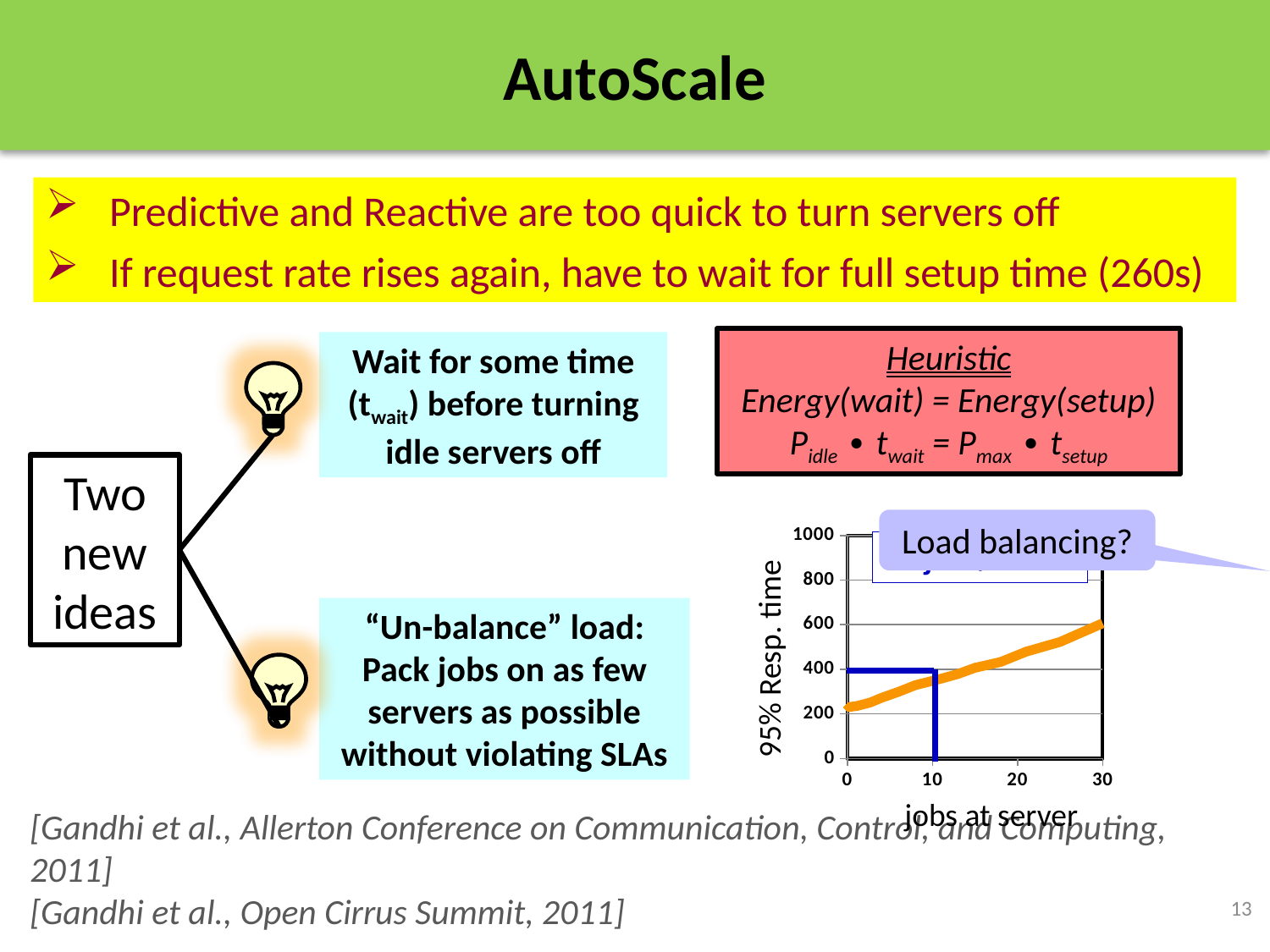
In the chart at the bottom right, is the 95% response time at 30 jobs at server greater or less than 400? greater In the chart at the bottom right, does the 95% response time rise or fall as the number of jobs at the server increases? rise In the chart at the bottom right, is the 95% response time at 30 jobs at server greater or less than 800? less In the chart at the bottom right, is the 95% response time higher at 30 jobs at server or at 0 jobs at server? 30 jobs at server In the chart at the bottom right, what is the label of the x axis? jobs at server In the chart at the bottom right, what is the highest value shown on the y axis? 1000 In the chart at the bottom right, what is the label of the y axis? 95% Resp. time What kind of chart is shown at the bottom right of the slide? line chart In the chart at the bottom right, what 95% response time do the blue guide lines mark at 10 jobs at server? 400 In the chart at the bottom right, is the 95% response time at 0 jobs at server greater or less than 400? less